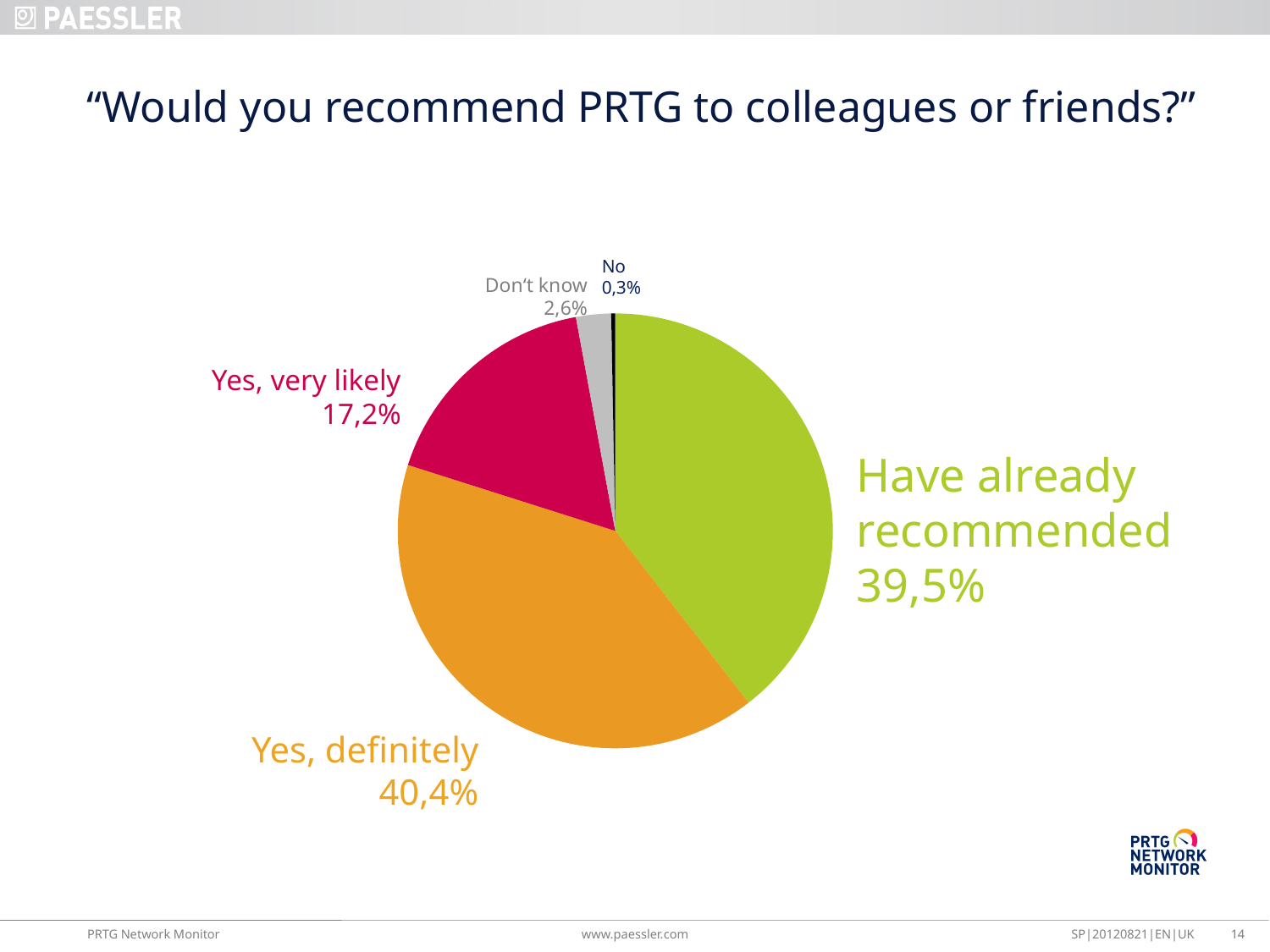
Which answer has the smallest share of the pie? No What is the difference between the "Yes, definitely" share and the "Have already recommended" share? 0,9% What percentage of respondents answered "Yes, definitely"? 40,4% What question is the pie chart answering, according to the slide title? "Would you recommend PRTG to colleagues or friends?" Which answer has the largest share of the pie? Yes, definitely What percentage of respondents answered "Have already recommended"? 39,5% Which is larger: the share for "Yes, very likely" or the share for "Don't know"? Yes, very likely What percentage of respondents answered "Don't know"? 2,6% What percentage of respondents answered "No"? 0,3% What percentage of respondents answered "Yes, very likely"? 17,2% What kind of chart is shown on the slide? Pie chart How many slices does the pie chart have? 5